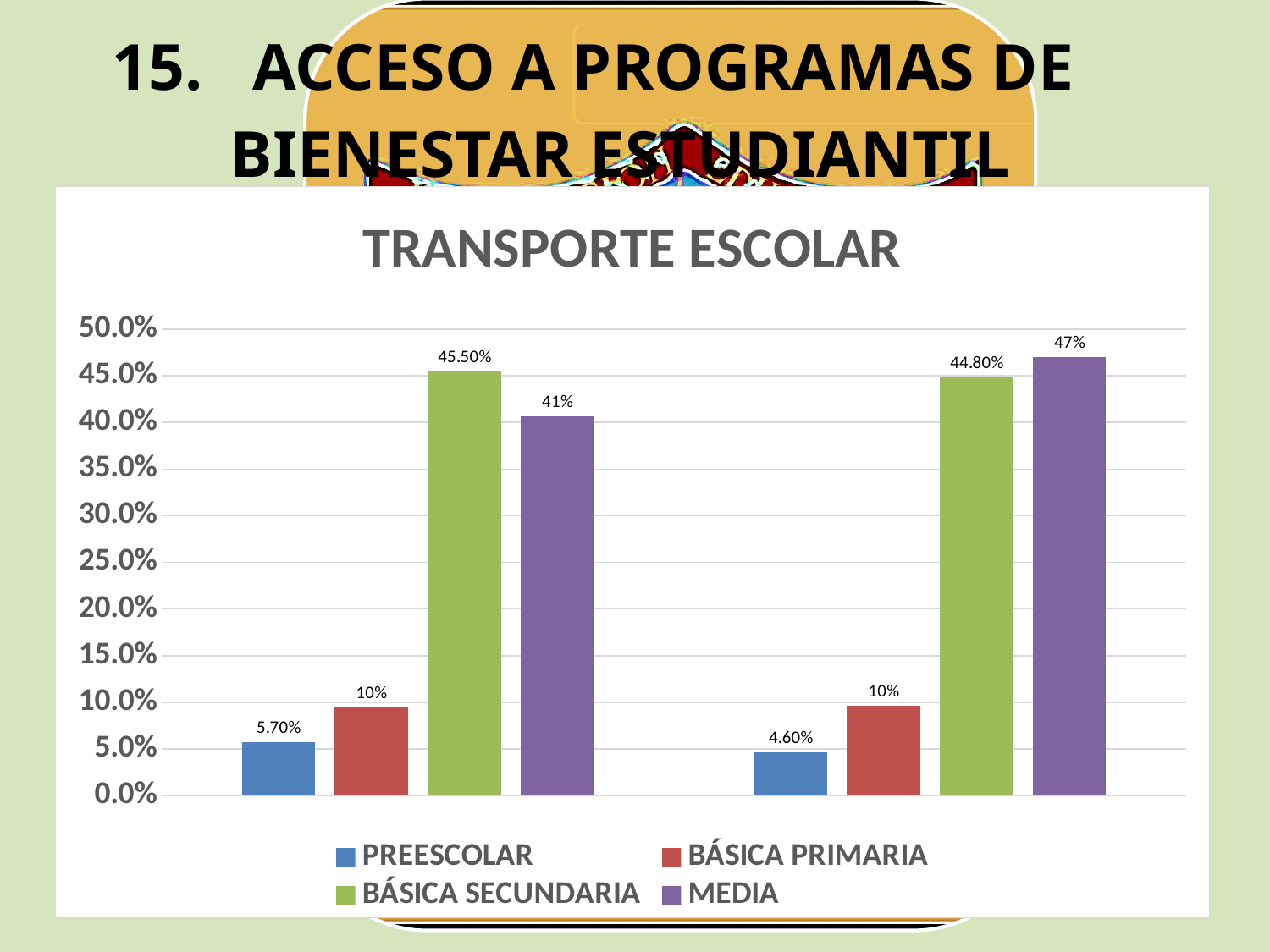
What kind of chart is shown on the slide? bar chart What is the value of the BÁSICA SECUNDARIA bar in the left group of bars? 45.50% What is the title of the chart? TRANSPORTE ESCOLAR Which series has the highest bar in the left group of bars? BÁSICA SECUNDARIA What is the value of the MEDIA bar in the right group of bars? 47% Which series has the lowest bar in the right group of bars? PREESCOLAR Is the value of the BÁSICA PRIMARIA bar in the left group greater or less than 20.0%? less What is the value of the PREESCOLAR bar in the right group of bars? 4.60% What is the value of the PREESCOLAR bar in the left group of bars? 5.70% In the right group of bars, which is larger: BÁSICA SECUNDARIA or MEDIA? MEDIA What is the difference between the MEDIA bar in the right group (47%) and the MEDIA bar in the left group (41%)? 6% How many series does the legend list? 4